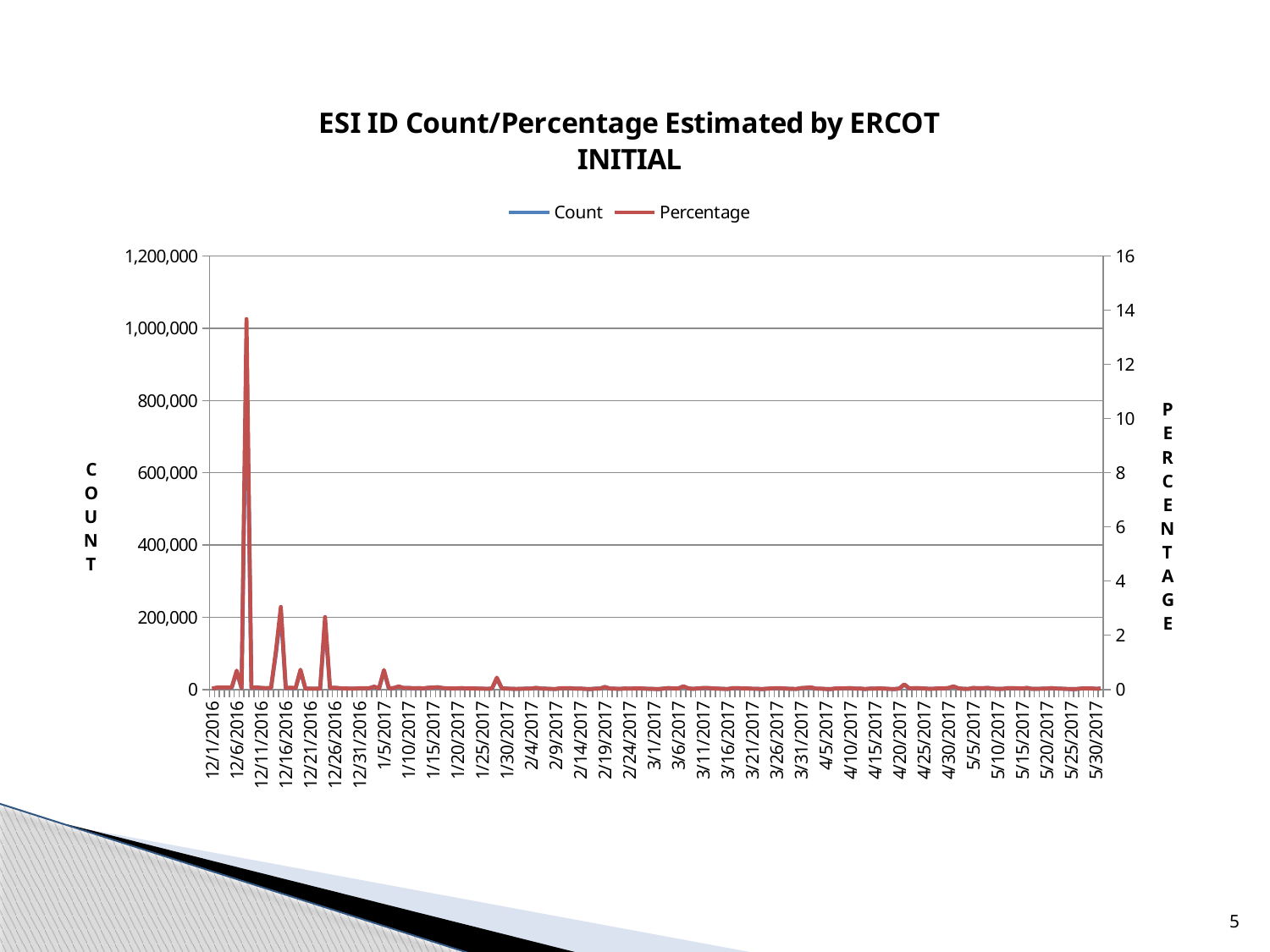
How many series does the legend list? 2 Is the highest value of the Count series greater or less than 800,000? greater What is the title of the chart? ESI ID Count/Percentage Estimated by ERCOT INITIAL Is the Count value on 3/1/2017 greater or less than 200,000? less Is the Percentage value on 4/5/2017 greater or less than 2? less Overall, do the values fall or rise from December 2016 to May 2017? fall Does the Count series peak near the beginning or near the end of the date range? near the beginning What kind of chart is shown on the slide? line chart What are the two series named in the legend? Count and Percentage